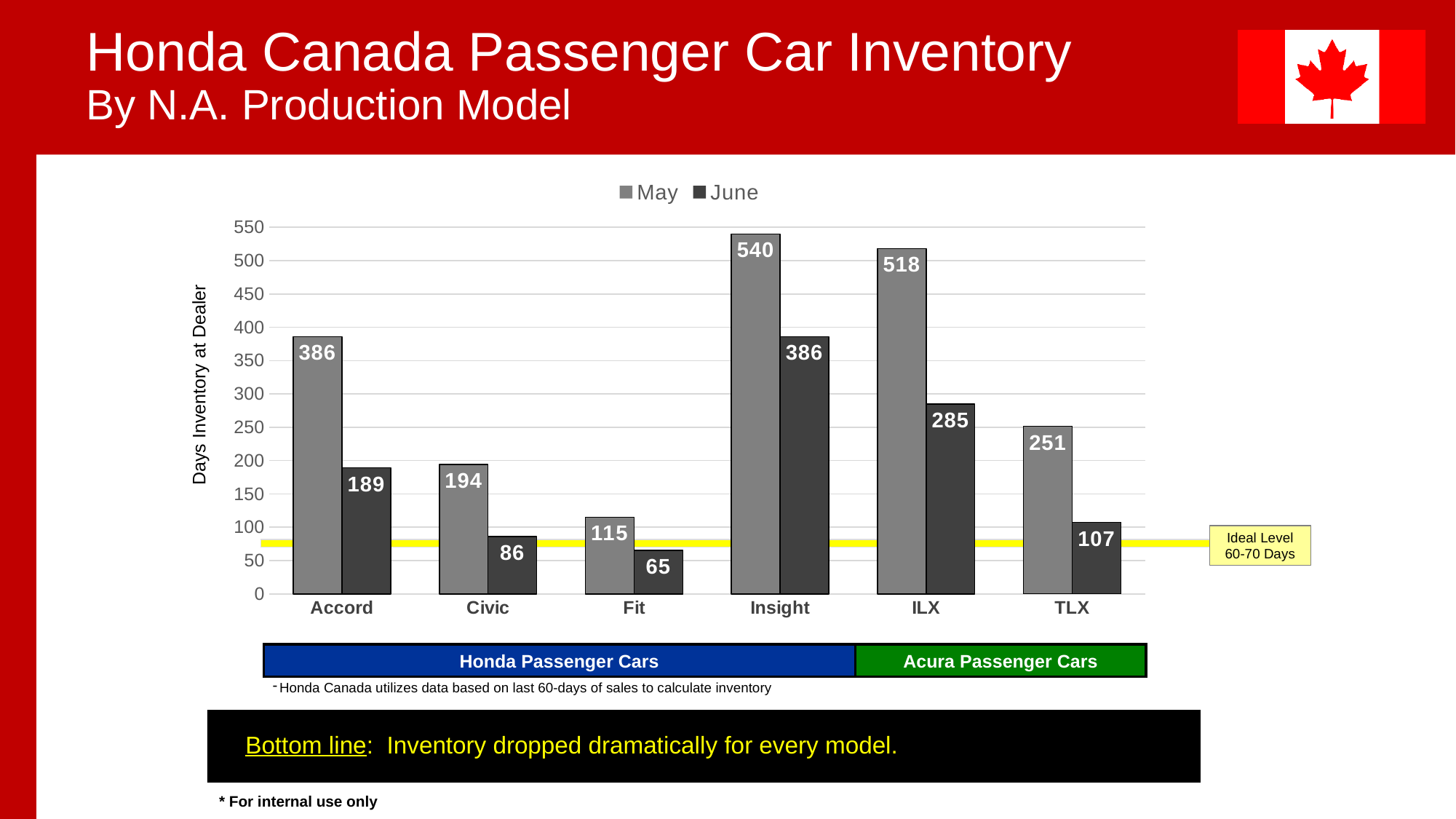
Which is larger, the June value for ILX or the June value for Accord? ILX Which model has the lowest June days inventory? Fit What is the May days inventory value for Insight? 540 Which model has the highest May days inventory? Insight What is the difference between the May and June values for Accord? 197 What is the June days inventory value for Civic? 86 What is the June days inventory value for TLX? 107 What kind of chart is shown on the slide? bar chart How many models are shown on the x axis? 6 How many series does the legend list? 2 What is the difference between the May values for ILX and TLX? 267 Is the June value for Fit greater or less than 100? less